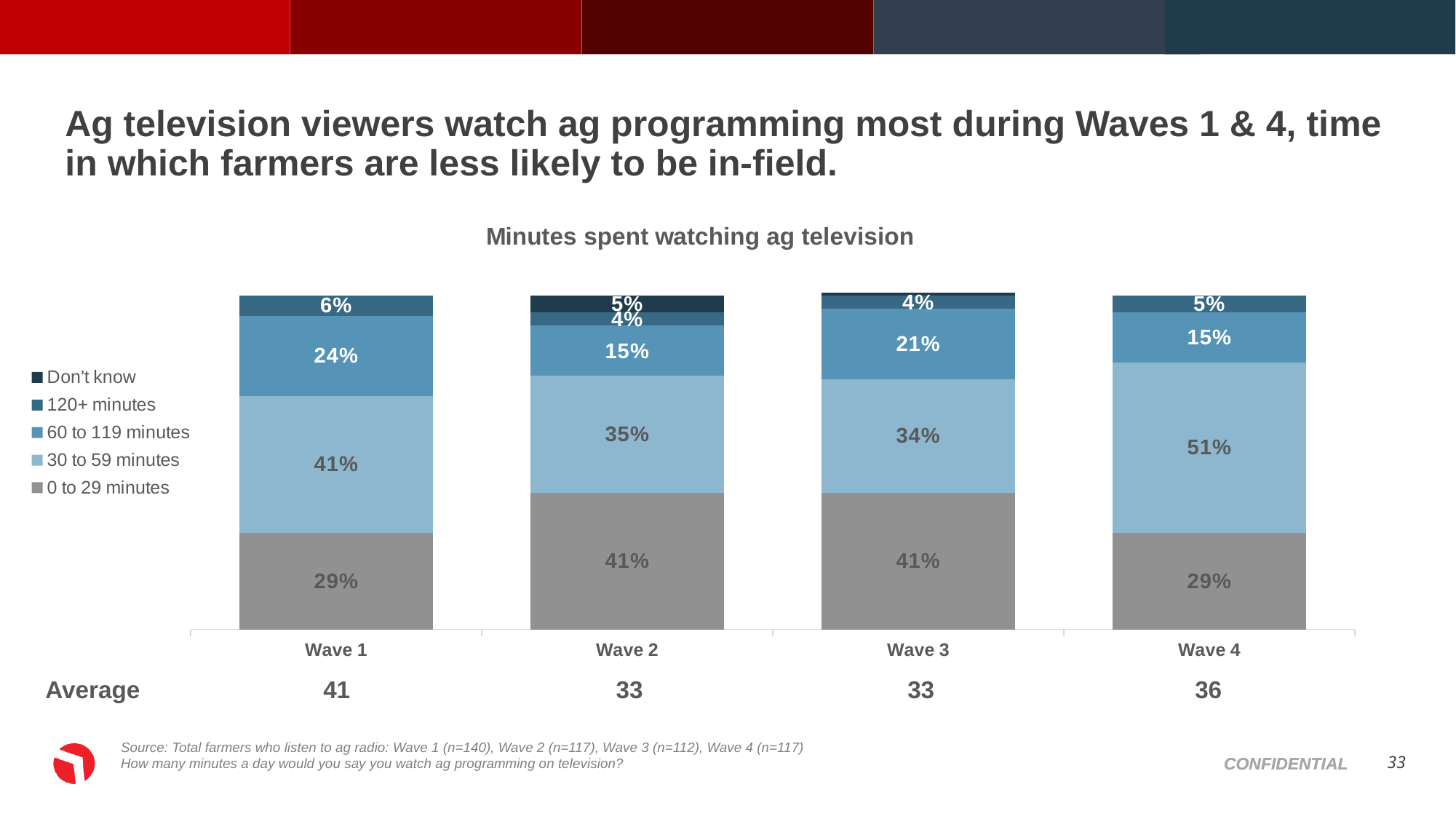
How many percentage points higher is the 30 to 59 minutes share in Wave 4 than in Wave 1? 10 Which has a larger 0 to 29 minutes share, Wave 2 or Wave 4? Wave 2 What is the 'Don't know' share for Wave 2? 5% What kind of chart is shown on the slide? Stacked bar chart How many series does the legend list? 5 What share of Wave 1 viewers watch 60 to 119 minutes? 24% Which wave has the highest share of viewers watching 60 to 119 minutes? Wave 1 What is the average number of minutes shown for Wave 1? 41 Which wave has the highest share of viewers watching 30 to 59 minutes? Wave 4 What share of Wave 4 viewers watch 30 to 59 minutes? 51% How many waves are shown on the x axis? 4 What share of Wave 2 viewers watch 0 to 29 minutes? 41%